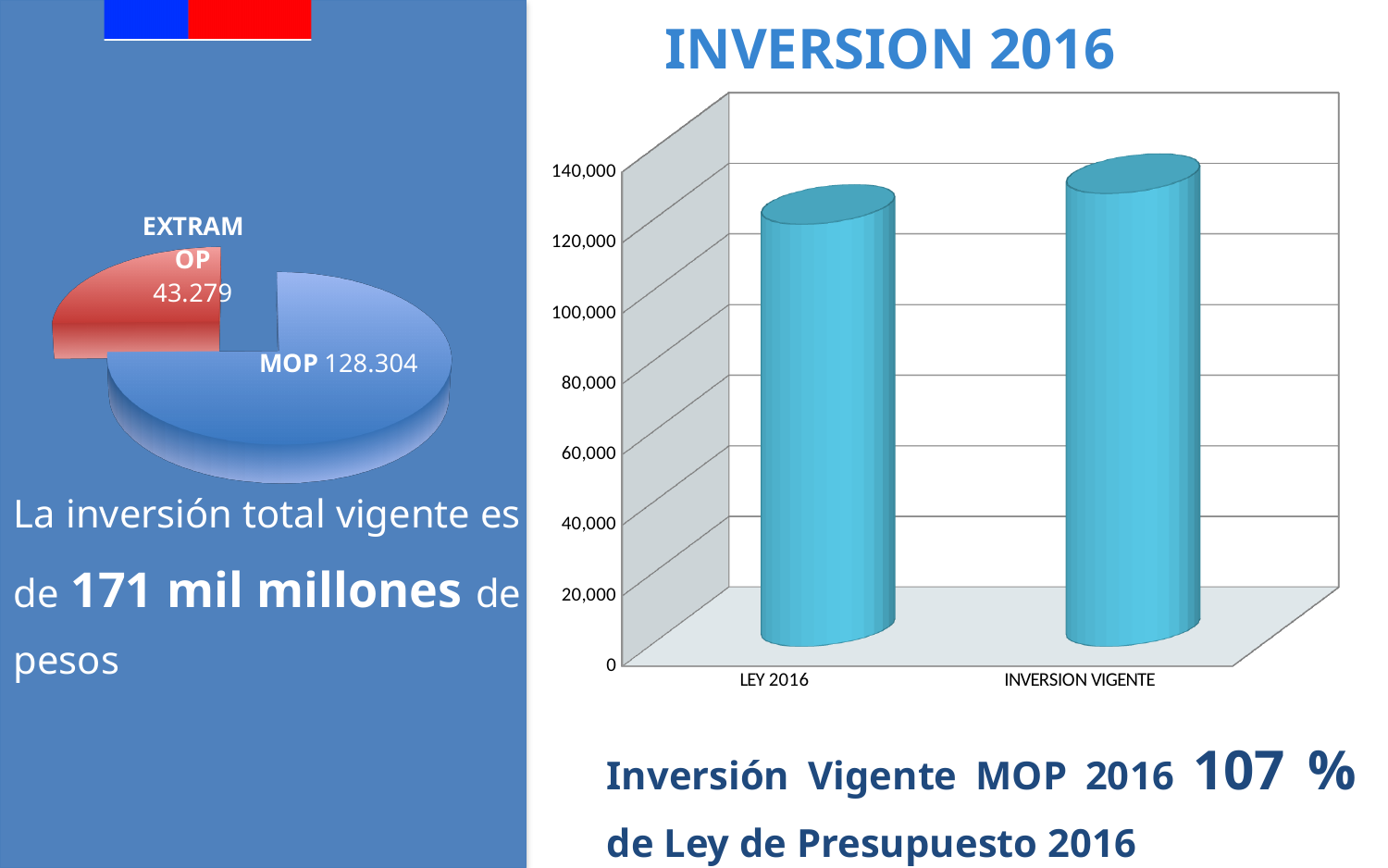
What is the title of the bar chart on the right of the slide? INVERSION 2016 On the pie chart on the left, what is the value for MOP? 128.304 On the pie chart on the left, which slice is larger, MOP or EXTRAMOP? MOP On the INVERSION 2016 chart, is the value for INVERSION VIGENTE greater or less than 140,000? less What kind of chart is the INVERSION 2016 chart? Bar chart What kind of chart is the chart on the left of the slide? Pie chart On the INVERSION 2016 chart, is the value for LEY 2016 greater or less than 100,000? greater On the pie chart on the left, how many slices are there? 2 On the pie chart on the left, what is the difference between the MOP value and the EXTRAMOP value? 85.025 On the INVERSION 2016 chart, which category has the higher bar, LEY 2016 or INVERSION VIGENTE? INVERSION VIGENTE On the pie chart on the left, what is the value for EXTRAMOP? 43.279 On the INVERSION 2016 chart, how many categories are shown on the x axis? 2